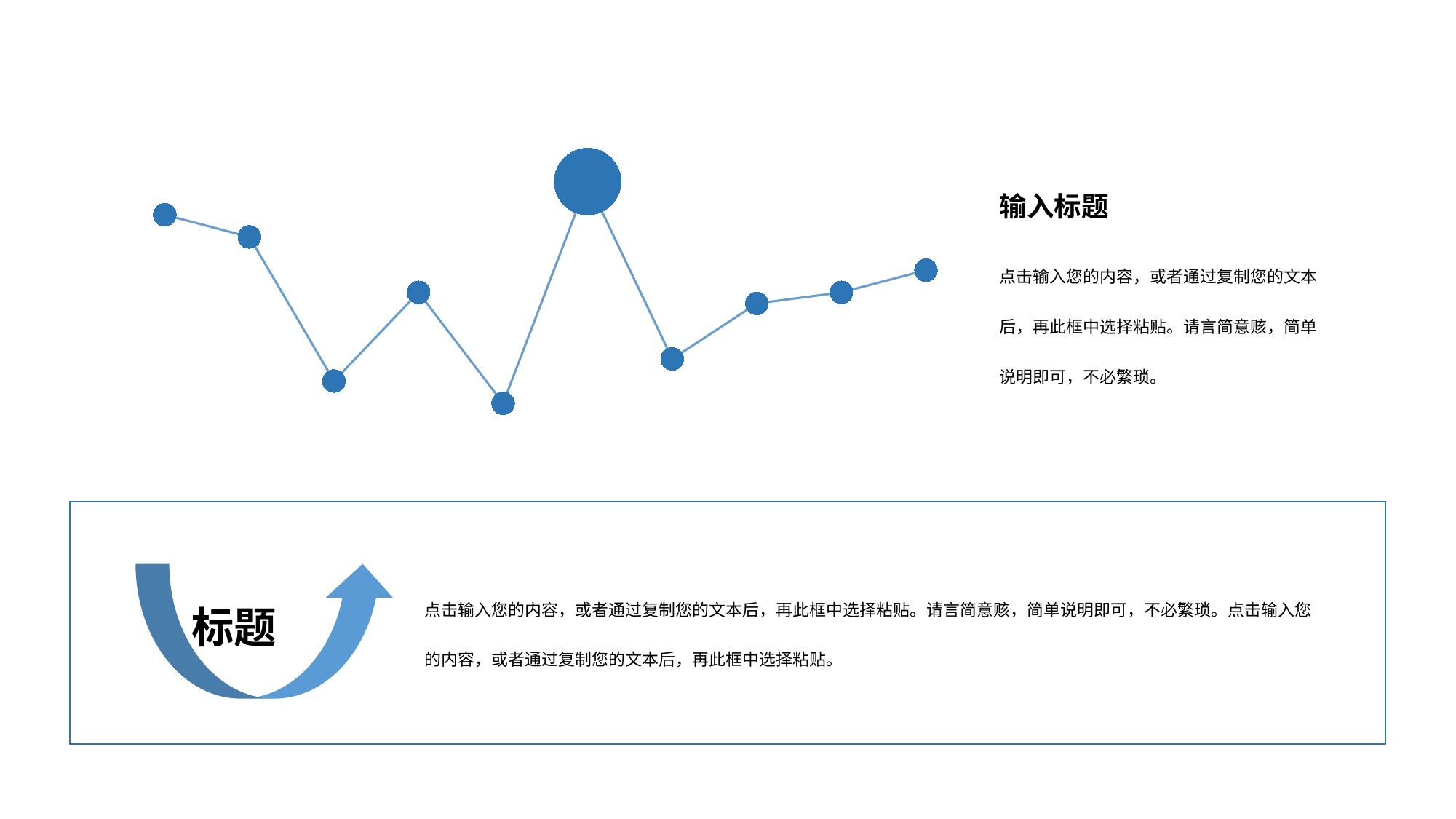
Counting from the left, which data point on the line chart is the lowest? the fifth point What kind of chart is shown on the slide? line chart What colour are the markers and line on the chart? blue Do the values on the line chart rise or fall from the first point to the third point from the left? fall How many data points are plotted on the line chart? 10 On the line chart, is the last point on the right higher or lower than the seventh point from the left? higher Which data point on the line chart is drawn with a noticeably larger marker than the others? the highest point (sixth from the left) Counting from the left, which data point on the line chart is the highest? the sixth point Do the values on the line chart rise or fall between the seventh point and the last point on the right? rise On the line chart, is the first point from the left higher or lower than the second point? higher